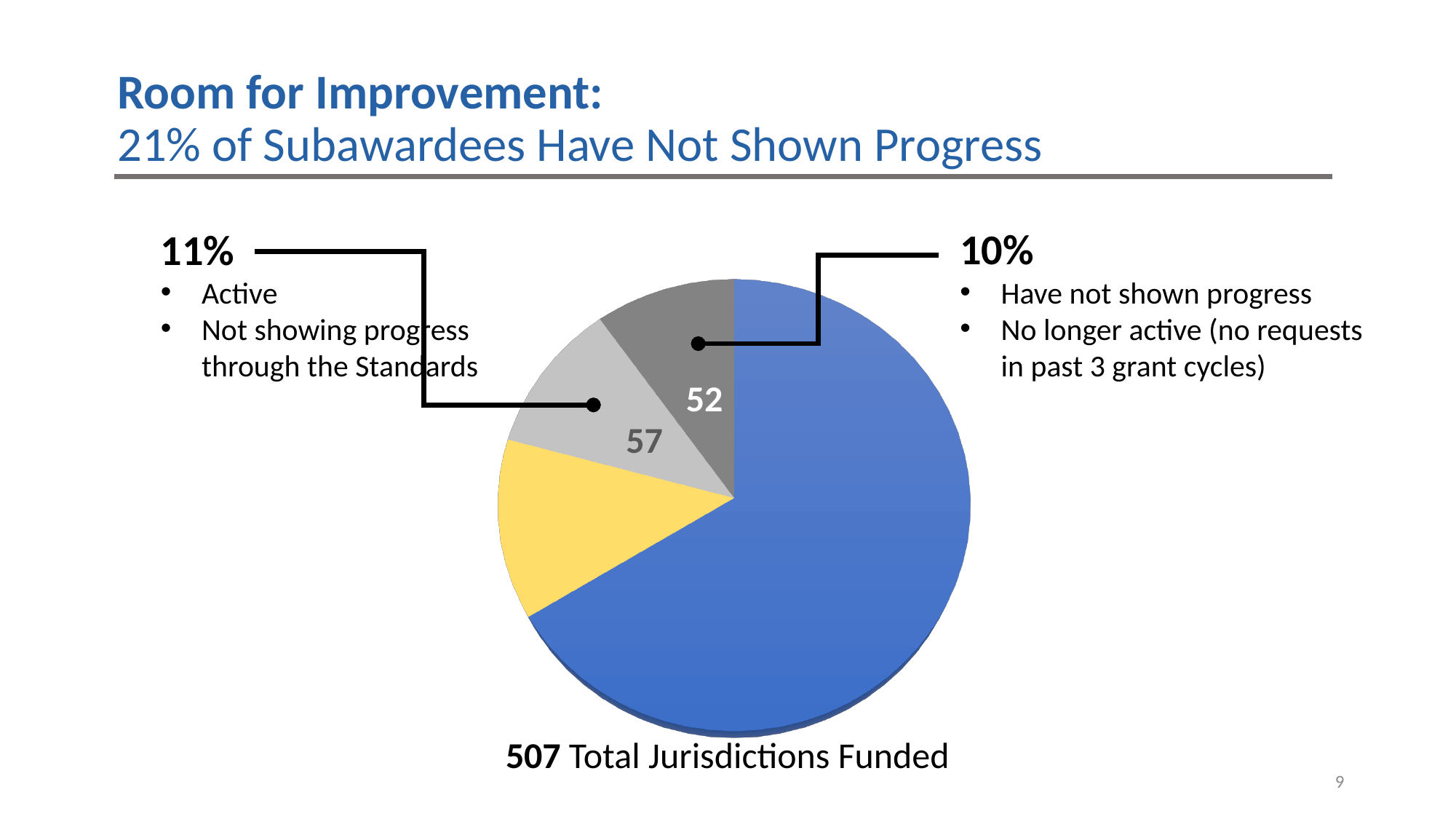
Which slice of the pie chart is the largest? the blue slice What value is printed on the dark gray slice of the pie chart? 52 What kind of chart is shown on the slide? pie chart Which slice is larger, the light gray slice or the dark gray slice? the light gray slice What is the difference between the light gray slice (57) and the dark gray slice (52)? 5 What share of the pie does the light gray slice (Active, not showing progress through the Standards) represent? 11% How many slices does the pie chart have? 4 What share of the pie does the dark gray slice (Have not shown progress, no longer active) represent? 10% What value is printed on the light gray slice of the pie chart? 57 According to the caption below the pie chart, how many total jurisdictions were funded? 507 According to the slide title, what percentage of subawardees have not shown progress? 21%